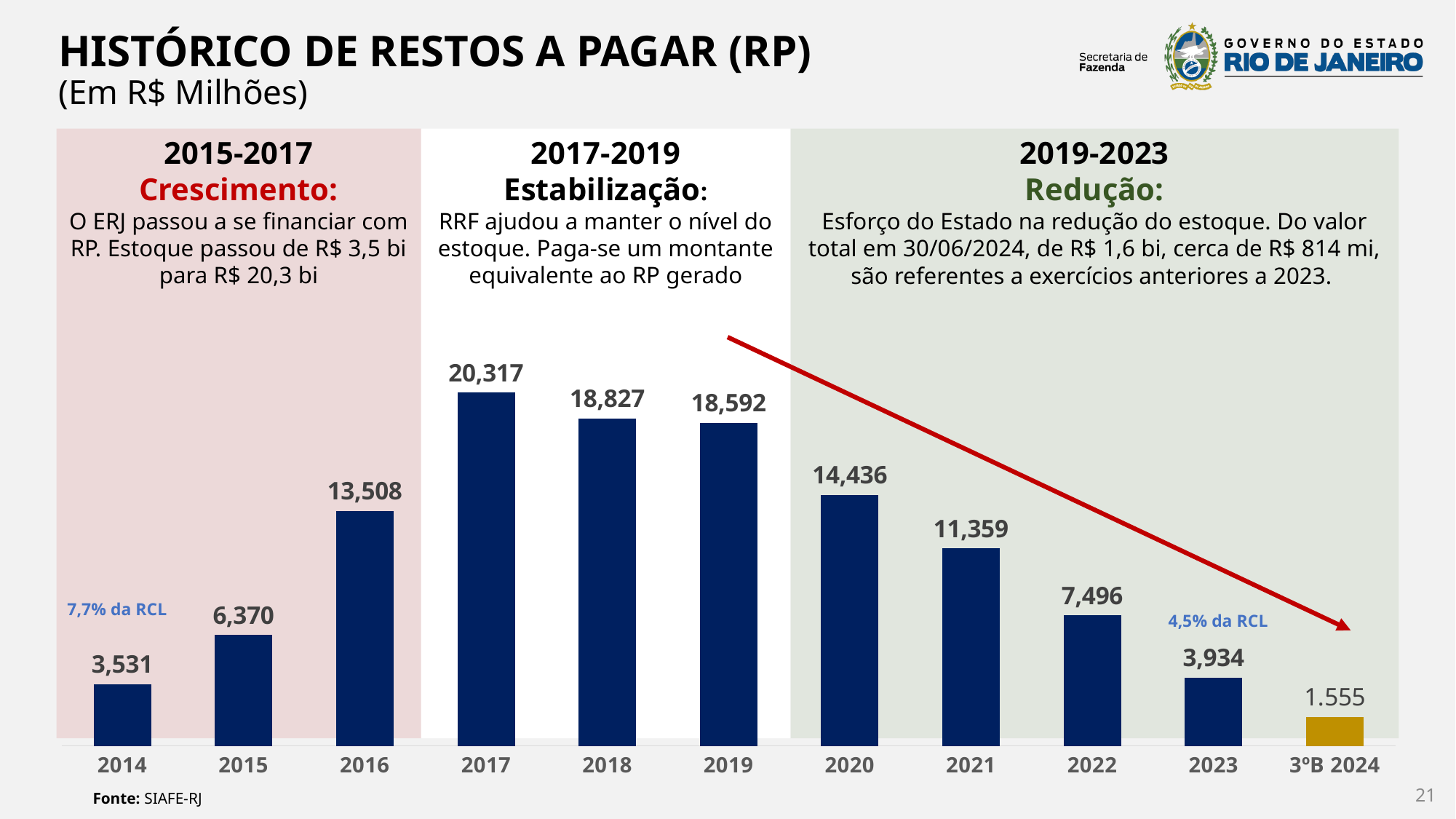
What is the value for 2021? 11,359 Which year has the highest value? 2017 What is the difference between the values for 2016 and 2015? 7,138 Which is larger, the value for 2016 or the value for 2020? 2020 Which category has the lowest value? 3ºB 2024 How many categories are shown on the x axis? 11 What is the difference between the values for 2017 and 2018? 1,490 What kind of chart is shown on the slide? Bar chart What is the title of the chart? HISTÓRICO DE RESTOS A PAGAR (RP) What is the value for 2017? 20,317 How do the values change from 2017 to 2023? They fall What is the value for 3ºB 2024? 1.555